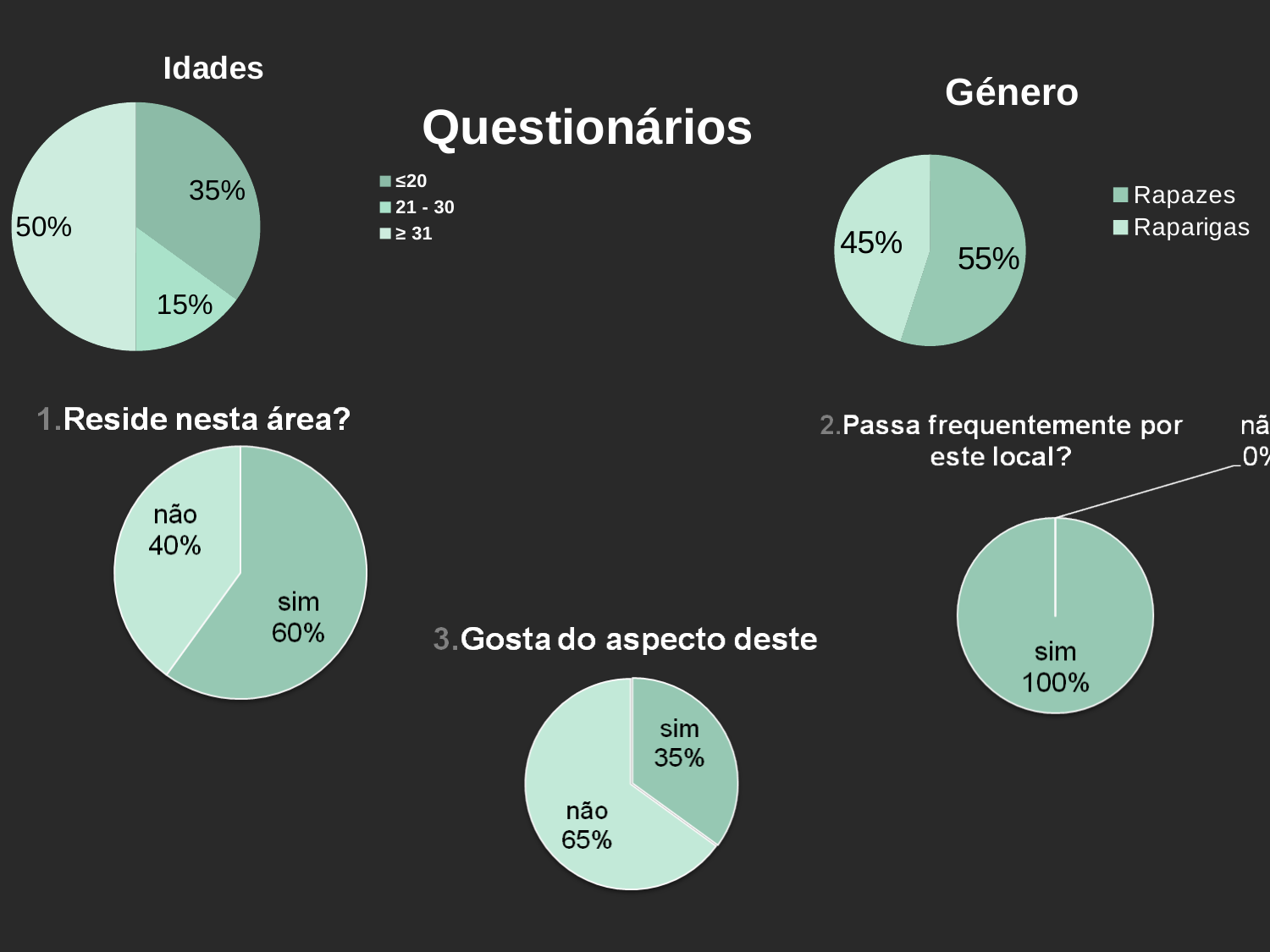
In the 'Passa frequentemente por este local?' chart, what percentage answered 'sim'? 100% In the 'Idades' chart, which age group has the largest slice? ≥ 31 In the 'Gosta do aspecto deste' chart, what percentage answered 'não'? 65% In the 'Idades' chart, which age group has the smallest slice? 21 - 30 In the 'Reside nesta área?' chart, what percentage answered 'sim'? 60% What type of chart is used for 'Gosta do aspecto deste'? Pie chart In the 'Reside nesta área?' chart, which answer has the larger slice, 'sim' or 'não'? sim In the 'Género' chart, what is the difference between the Rapazes and Raparigas percentages? 10% In the 'Idades' chart, what share is labelled for the ≥ 31 group? 50% In the 'Idades' chart, what share is labelled for the 21 - 30 group? 15% In the 'Género' chart, what percentage is shown for Rapazes? 55% How many categories does the legend of the 'Idades' chart list? 3